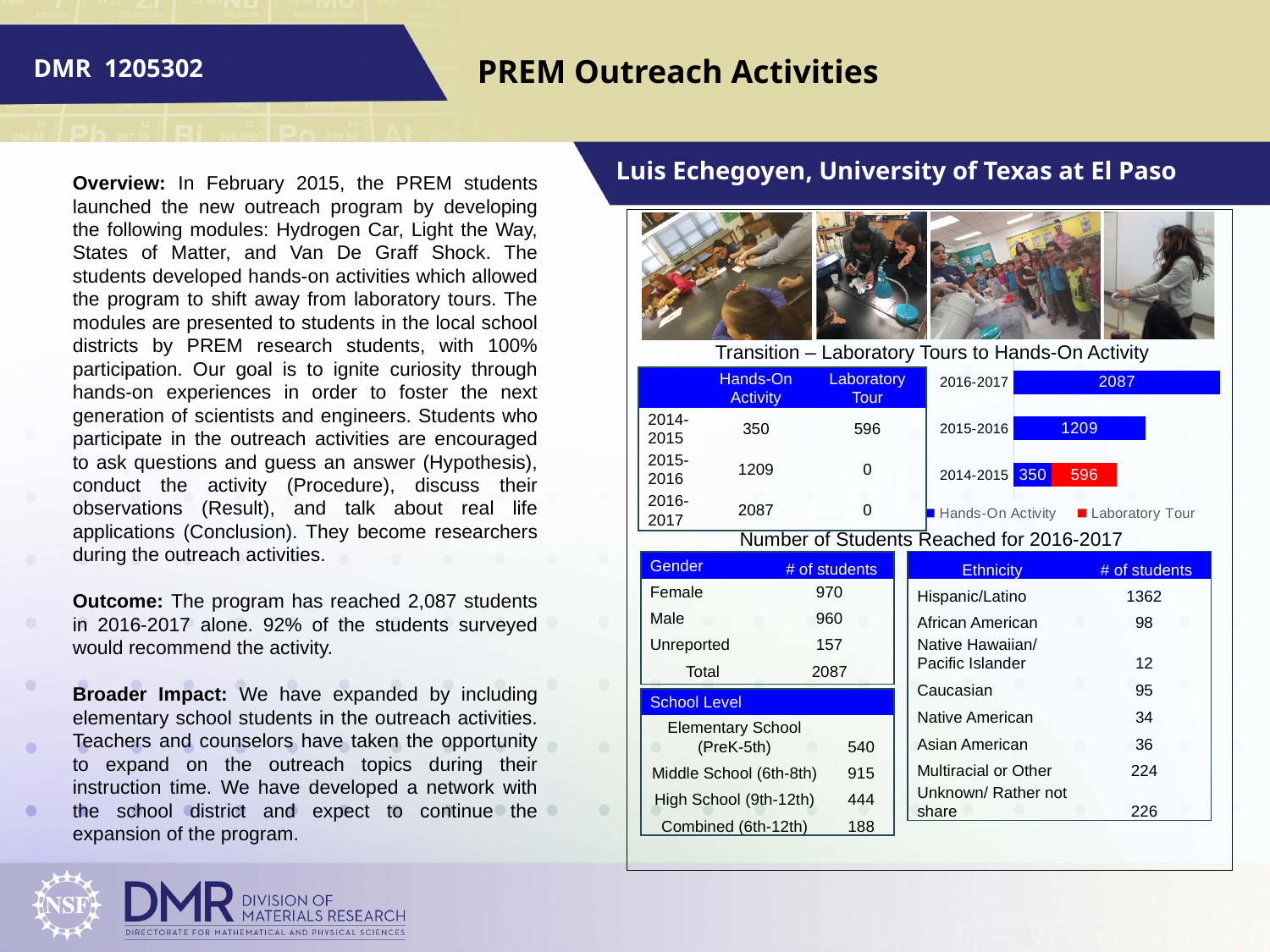
In the bar chart, which year has the highest Hands-On Activity value? 2016-2017 In the bar chart, which year has the lowest Hands-On Activity value? 2014-2015 How many series does the legend of the bar chart list? 2 In the bar chart, what is the Hands-On Activity value for 2014-2015? 350 In the bar chart, what is the Hands-On Activity value for 2015-2016? 1209 In the bar chart, what is the difference between the Hands-On Activity values for 2016-2017 and 2015-2016? 878 What type of chart is shown under the heading 'Transition – Laboratory Tours to Hands-On Activity'? bar chart In the bar chart, what is the total of the stacked bar for 2014-2015? 946 In the bar chart, what is the Hands-On Activity value for 2016-2017? 2087 In the bar chart, which is larger for 2014-2015: Hands-On Activity or Laboratory Tour? Laboratory Tour In the bar chart, what is the Laboratory Tour value for 2014-2015? 596 How many year categories are shown in the bar chart? 3